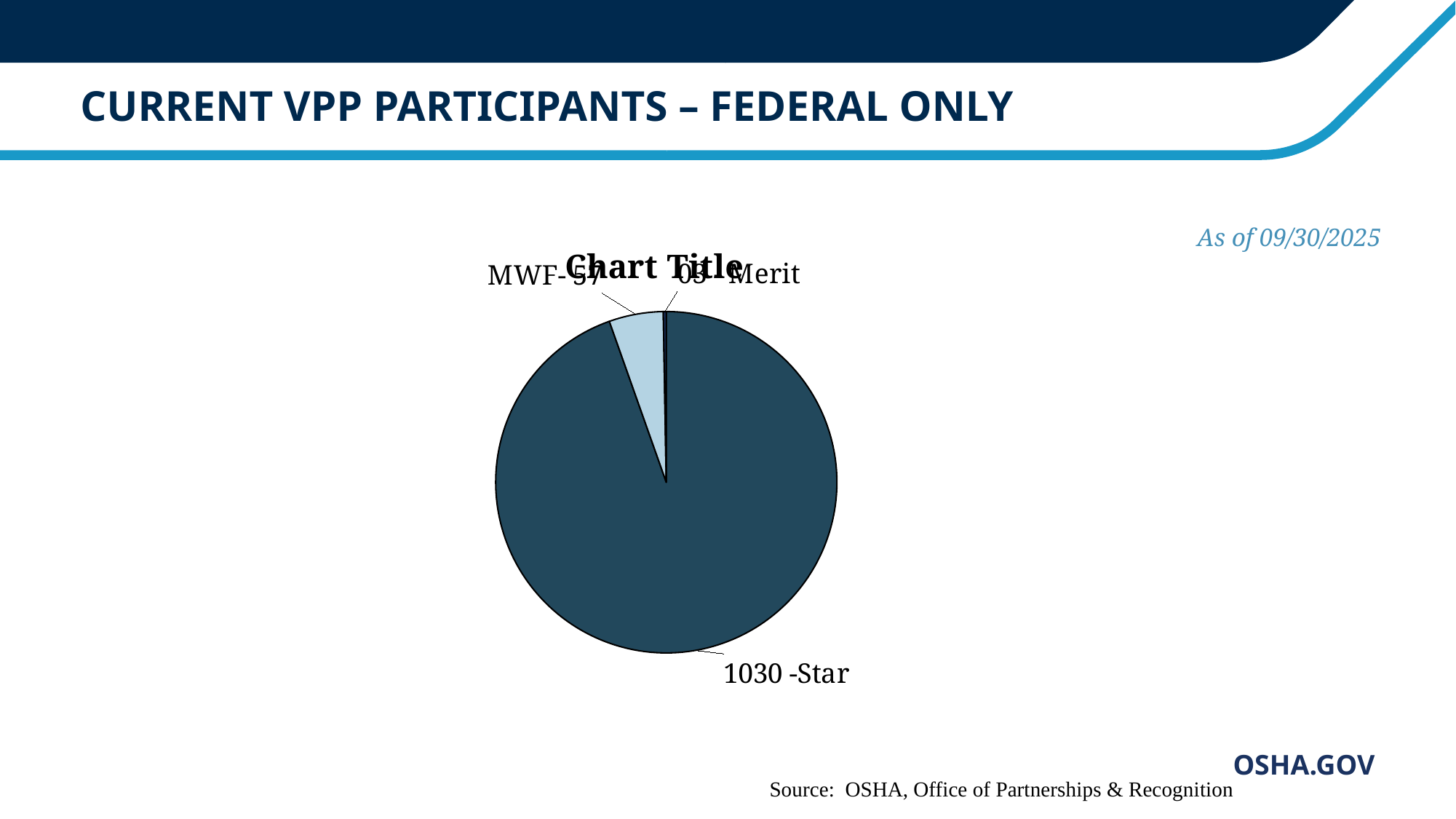
Which category has the smallest slice of the pie chart? Merit What kind of chart is shown on the slide? pie chart What is the title printed above the pie chart? Chart Title What is the value shown for the Star slice? 1030 Which slice is larger, Star or MWF? Star Is the value for Star greater or less than 1000? greater What colour is the MWF slice of the pie chart? light blue How many slices does the pie chart have? 3 Which category has the largest slice of the pie chart? Star Which slice is larger, MWF or Merit? MWF